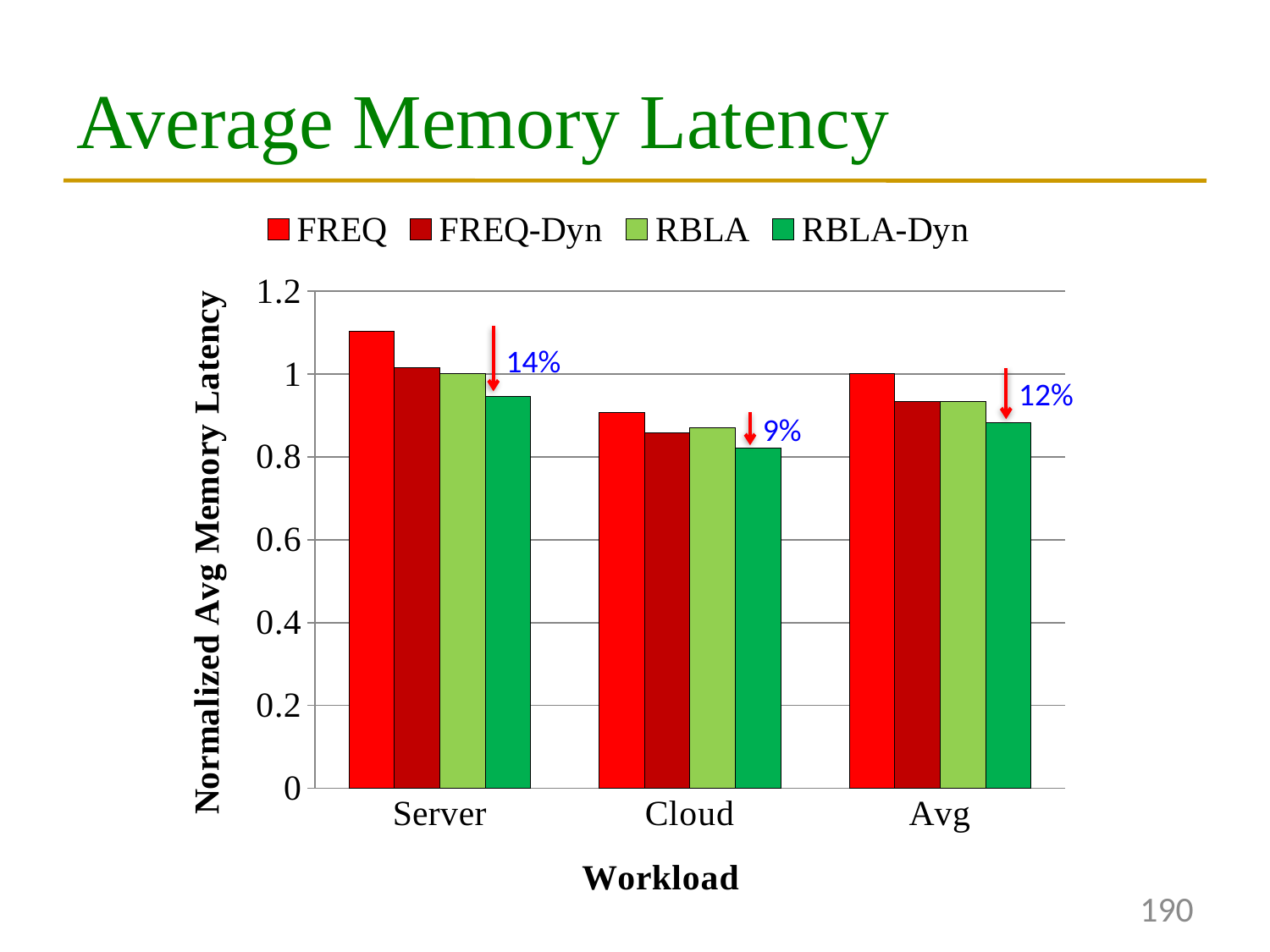
What kind of chart is shown on the slide? bar chart How many series does the legend list? 4 How many workload categories are shown on the x axis? 3 For the Avg workload, which is larger: the FREQ bar or the RBLA-Dyn bar? FREQ Is the FREQ value for the Cloud workload greater or less than 0.8? greater What is the label of the y axis? Normalized Avg Memory Latency Which workload has the lowest RBLA-Dyn bar? Cloud Is the FREQ value for the Server workload greater or less than 1? greater Which series has the highest normalized average memory latency for the Server workload? FREQ Is the RBLA-Dyn value for the Cloud workload greater or less than 1? less Which series has the lowest normalized average memory latency for the Cloud workload? RBLA-Dyn What percentage reduction is annotated above the RBLA-Dyn bar for the Server workload? 14%